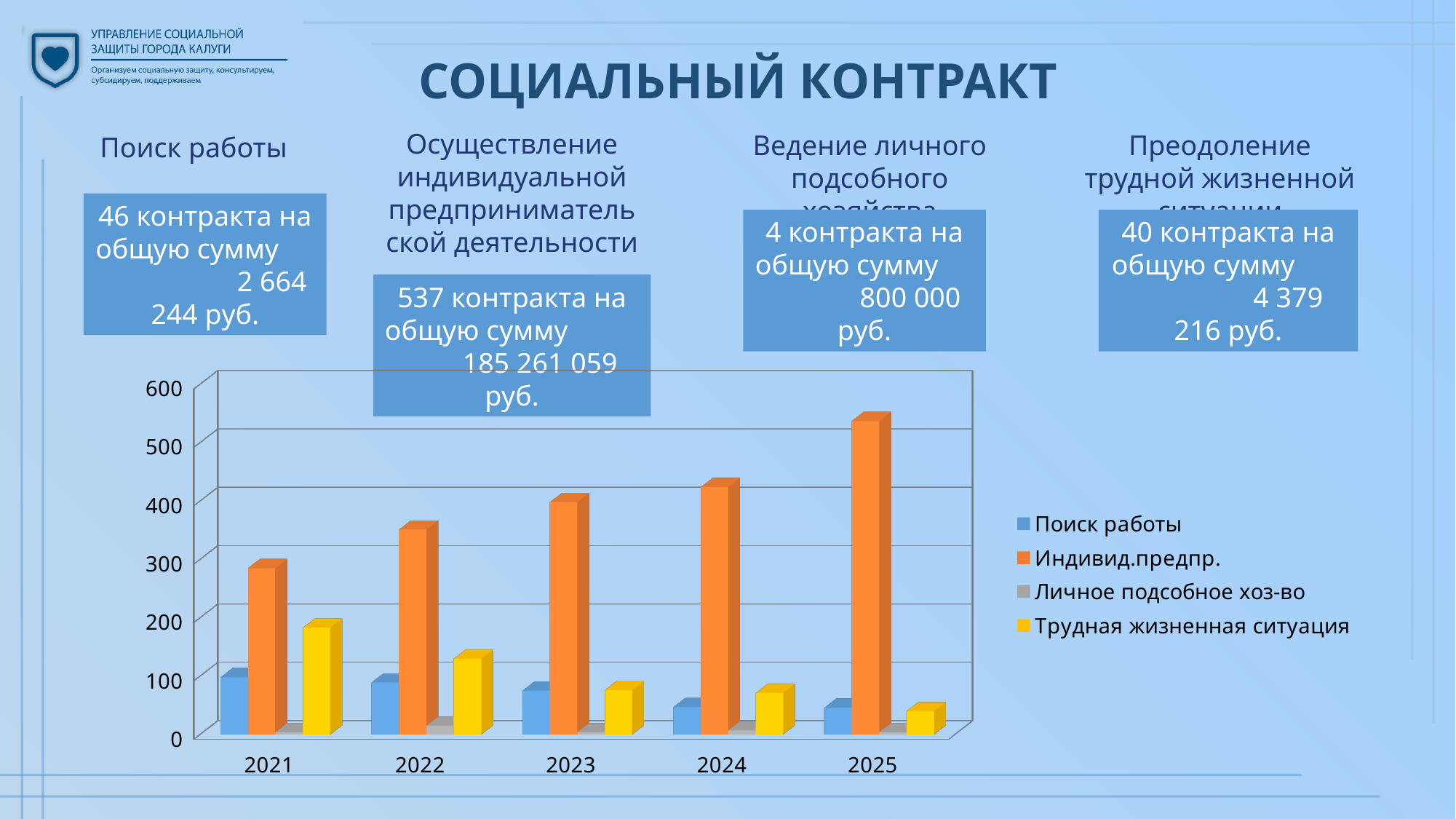
How many years are shown on the x axis of the chart? 5 Do the values for Трудная жизненная ситуация rise or fall from 2021 to 2025? fall Which series has the lowest bars in every year? Личное подсобное хоз-во How many series does the chart legend list? 4 In which year is the bar for Индивид.предпр. the highest? 2025 Is the value for Поиск работы in 2024 greater or less than 100? less Which is larger in 2022: Поиск работы or Трудная жизненная ситуация? Трудная жизненная ситуация Is the value for Индивид.предпр. in 2025 greater or less than 500? greater Do the values for Индивид.предпр. rise or fall from 2021 to 2025? rise What kind of chart is shown on the slide? bar chart